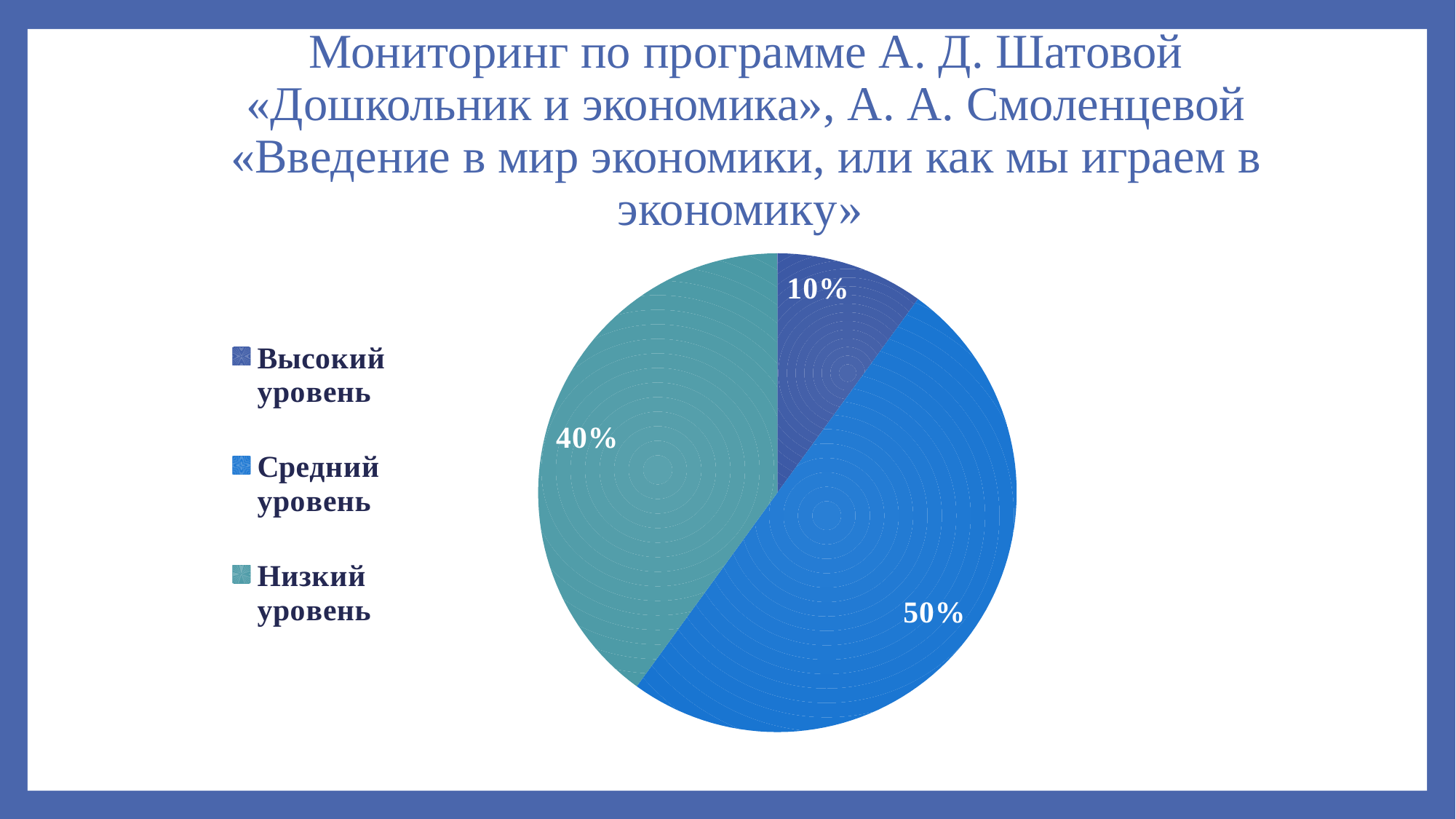
What share of the pie does "Высокий уровень" have? 10% How many slices does the pie chart have? 3 What kind of chart is shown on the slide? pie chart What is the difference in percentage points between "Низкий уровень" and "Высокий уровень"? 30 Which is larger, the slice for "Низкий уровень" or the slice for "Средний уровень"? Средний уровень Which category has the largest slice of the pie? Средний уровень What is the difference in percentage points between "Средний уровень" and "Высокий уровень"? 40 What share of the pie does "Низкий уровень" have? 40% Which category has the smallest slice of the pie? Высокий уровень How many entries does the legend list? 3 What share of the pie does "Средний уровень" have? 50% Which legend entry is shown in the teal/green colour? Низкий уровень